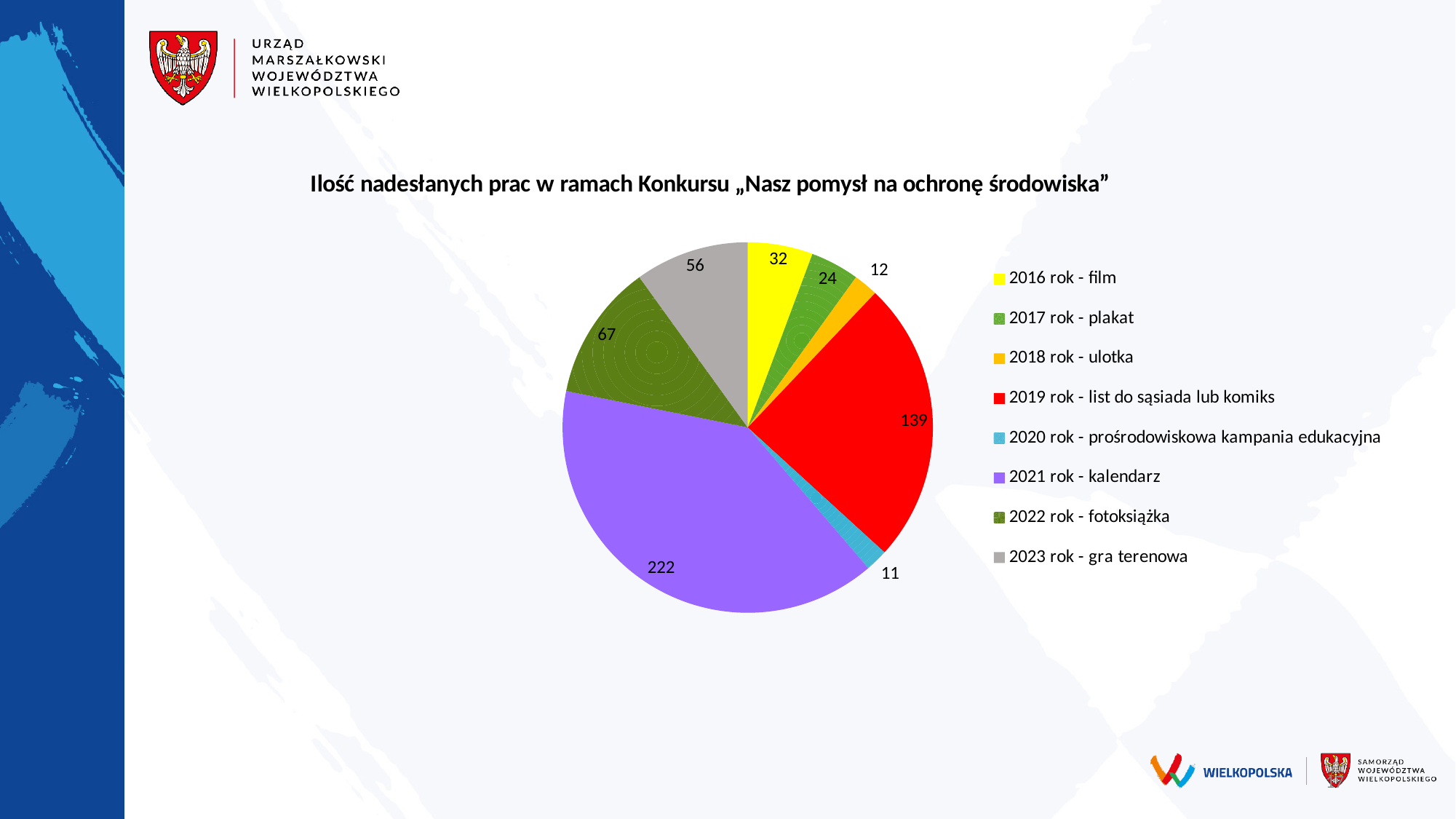
What is the value for 2017 rok - plakat? 24 Which category has the lowest value? 2020 rok - prośrodowiskowa kampania edukacyjna What is the title of the chart? Ilość nadesłanych prac w ramach Konkursu „Nasz pomysł na ochronę środowiska” What is the difference between the values for 2021 rok - kalendarz and 2019 rok - list do sąsiada lub komiks? 83 How many slices does the pie chart have? 8 What is the value for 2021 rok - kalendarz? 222 What is the value for 2019 rok - list do sąsiada lub komiks? 139 What colour is the slice for 2016 rok - film? yellow What type of chart is shown on the slide? pie chart What is the value for 2023 rok - gra terenowa? 56 Which is larger, the value for 2022 rok - fotoksiążka or 2023 rok - gra terenowa? 2022 rok - fotoksiążka Which category has the highest value? 2021 rok - kalendarz